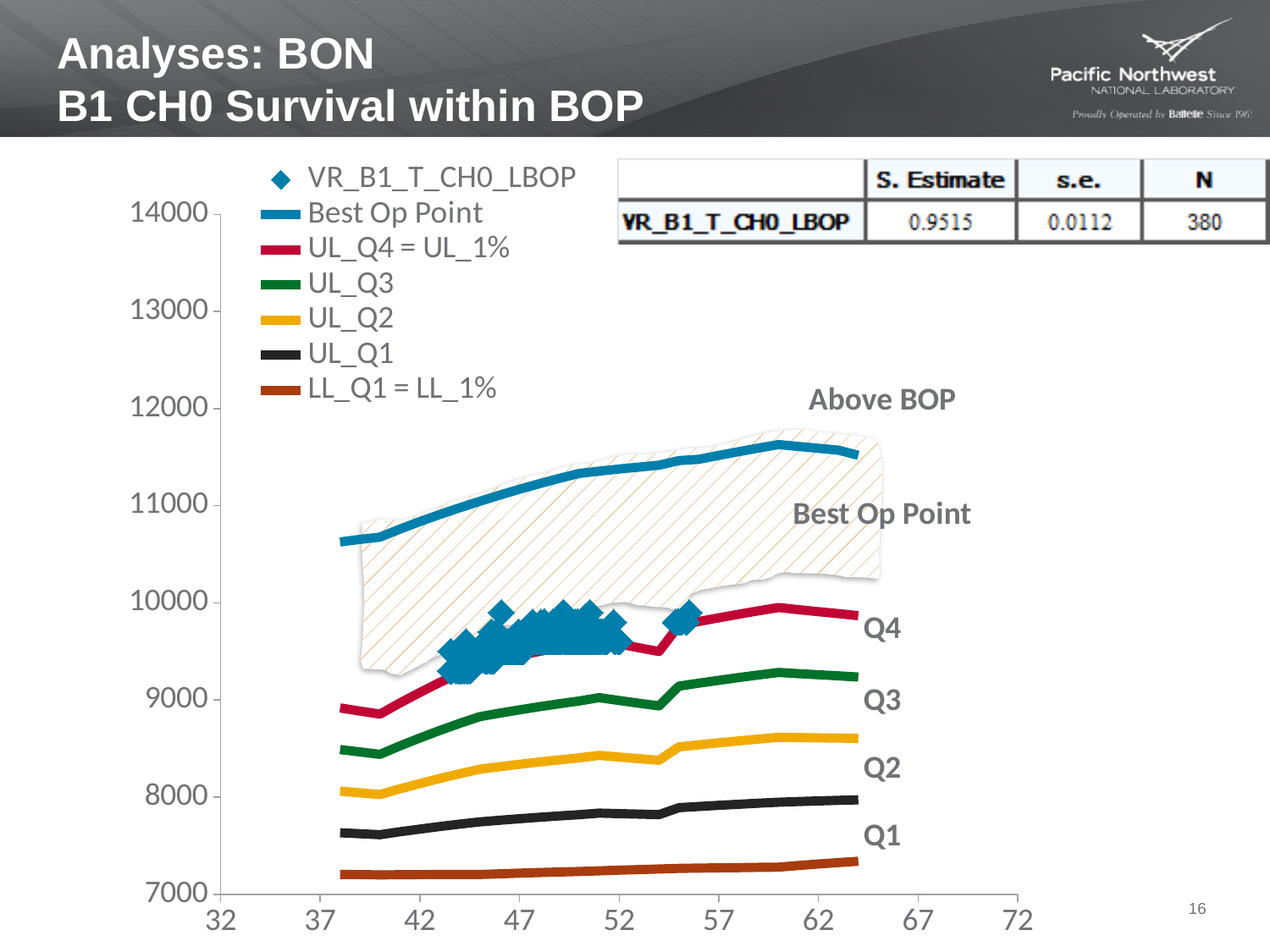
Which is larger at x = 57, the Best Op Point line or the UL_Q4 = UL_1% line? Best Op Point Is the value of the UL_Q2 line at x = 62 greater or less than 9000? less Is the value of the LL_Q1 = LL_1% line at x = 42 greater or less than 8000? less Which series in the chart has the lowest values across the x axis? LL_Q1 = LL_1% What marker shape does the legend use for the VR_B1_T_CH0_LBOP series? diamond What kind of chart is shown on the slide? line chart Is the value of the Best Op Point line at x = 62 greater or less than 11000? greater What colour is the UL_Q3 line in the chart? green Does the UL_Q1 line generally rise or fall as x increases from 38 to 64? rise How many series does the chart legend list? 7 Which series in the chart has the highest values across the x axis? Best Op Point